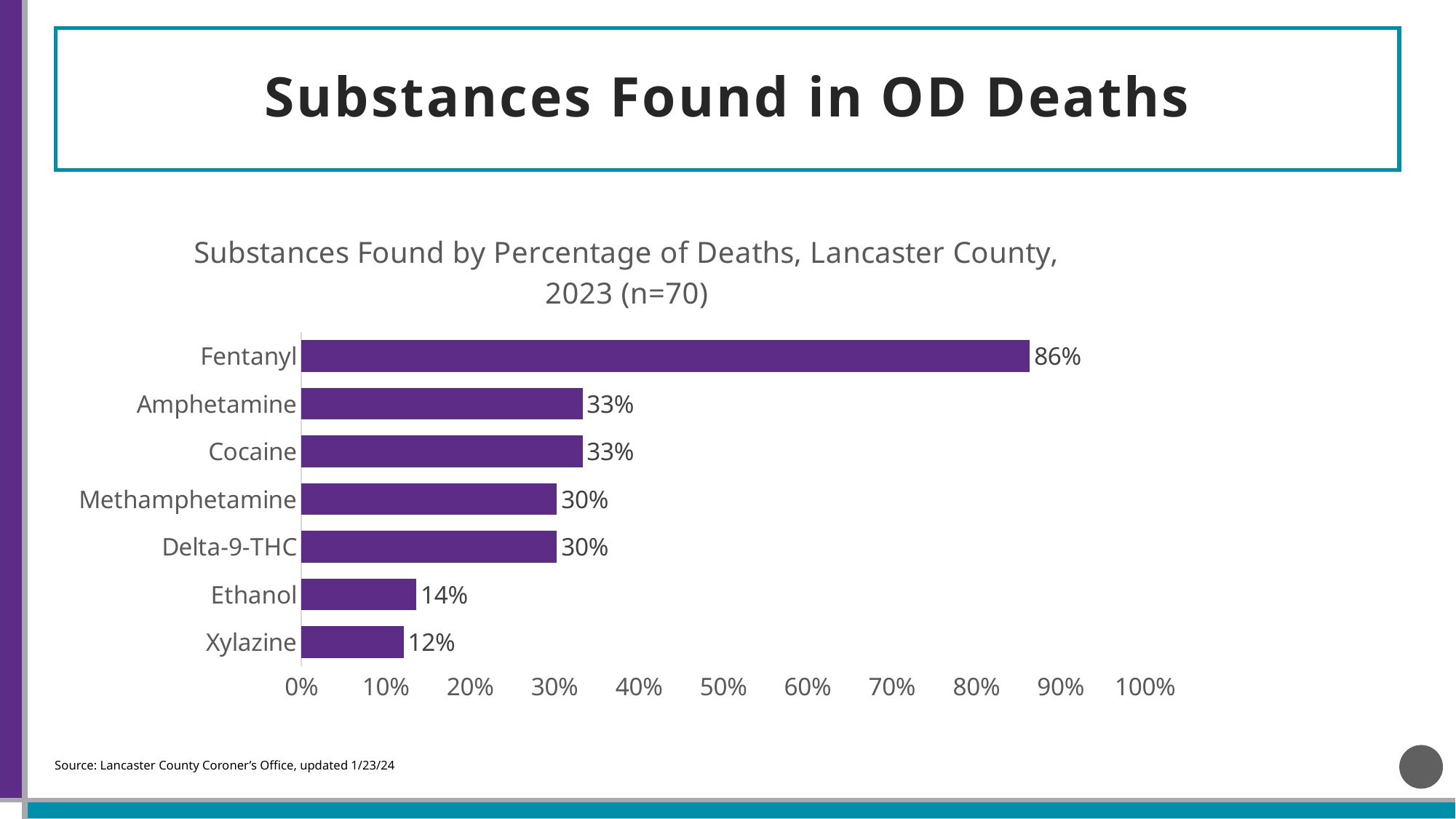
Which is larger, the value for Amphetamine or the value for Ethanol? Amphetamine What is the title of the chart? Substances Found by Percentage of Deaths, Lancaster County, 2023 (n=70) What is the difference between the Ethanol and Xylazine percentages? 2% What percentage of deaths had Fentanyl present? 86% How many substances are shown in the chart? 7 What percentage is shown for Methamphetamine? 30% Is the value for Delta-9-THC greater or less than 40%? less What is the value shown for Xylazine? 12% Which substance has the highest percentage? Fentanyl What kind of chart is shown on the slide? Bar chart What is the difference between the Fentanyl and Cocaine percentages? 53% Which substance has the lowest percentage? Xylazine